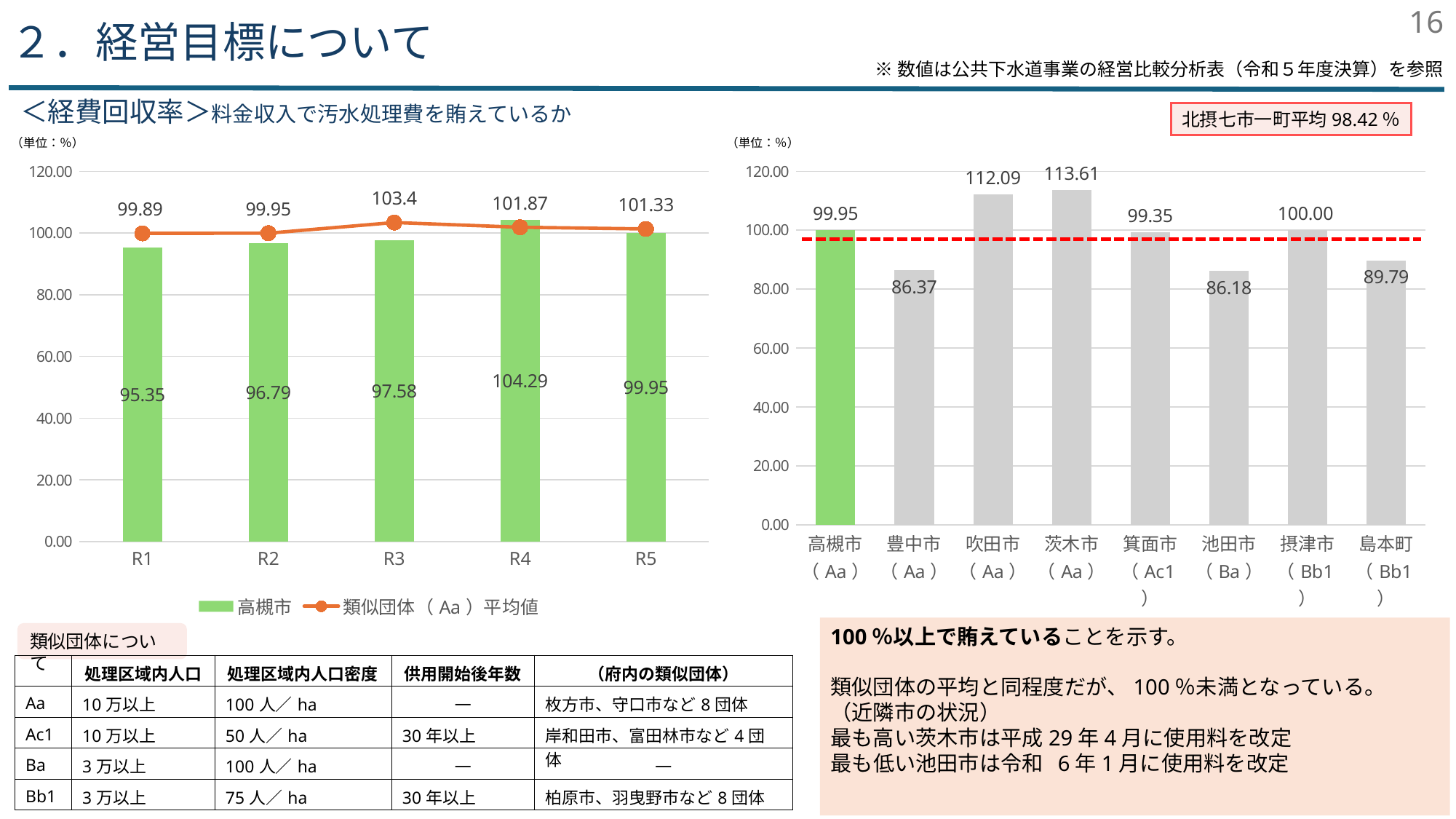
In the left chart, do the 高槻市 bar values rise or fall from R1 to R3? rise In the left chart, what is the value of the 高槻市 bar for R4? 104.29 What kind of chart is the right chart? bar chart In the right chart, what is the difference between the values for 吹田市 and 豊中市? 25.72 In the left chart, which year has the lowest 高槻市 bar? R1 In the right chart, which municipality has the highest value? 茨木市 In the right chart, how many municipalities are shown? 8 In the left chart, what is the 類似団体（Aa）平均値 value for R3? 103.4 In the right chart, what is the value for 茨木市? 113.61 In the right chart, which municipality has the lowest value? 池田市 In the left chart, how many series does the legend list? 2 In the left chart, what is the difference between the 高槻市 value and the 類似団体（Aa）平均値 value for R1? 4.54